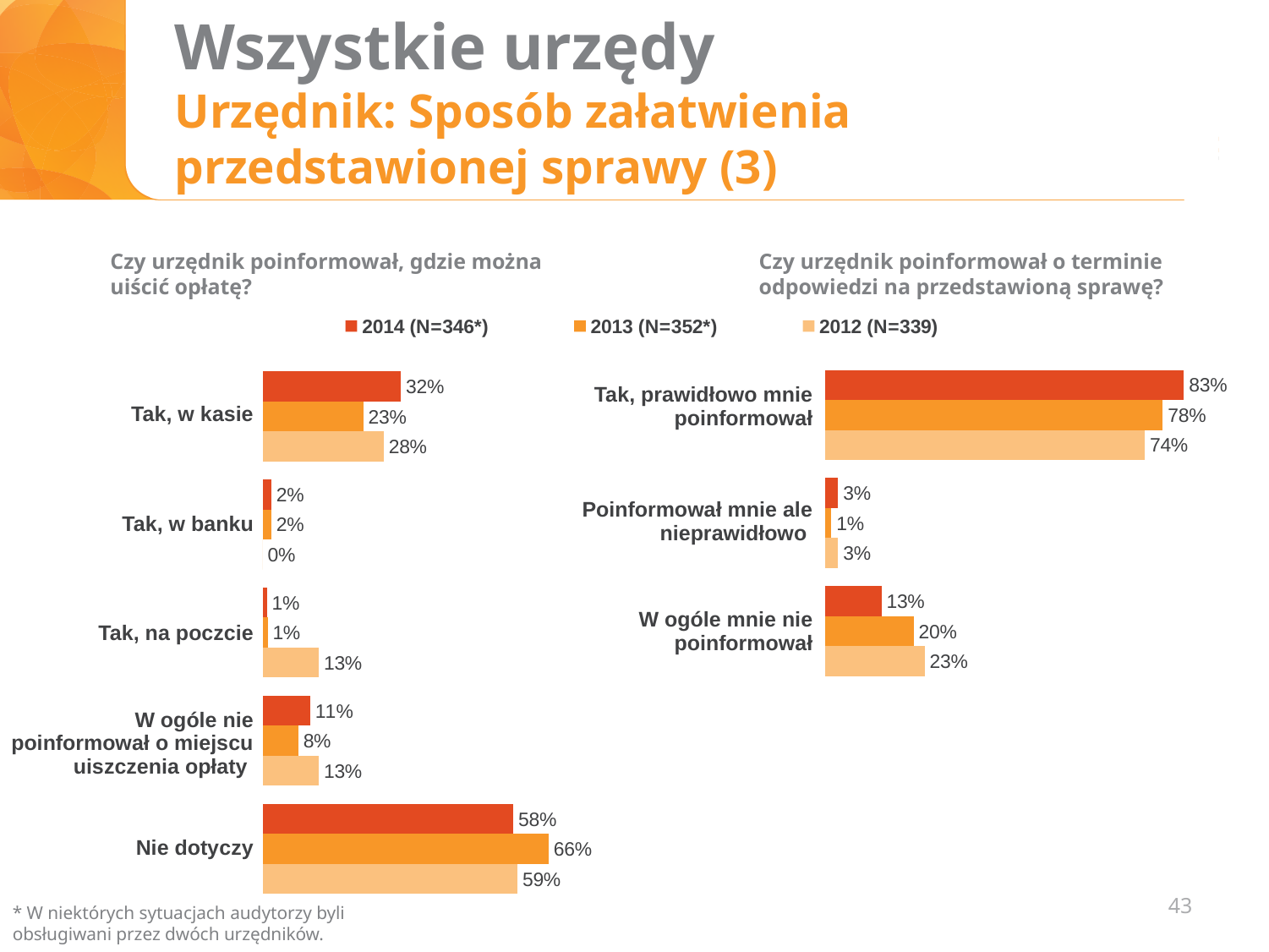
In the right chart, which is larger for "W ogóle mnie nie poinformował": the 2013 value or the 2014 value? 2013 In the right chart ("Czy urzędnik poinformował o terminie odpowiedzi na przedstawioną sprawę?"), what is the value for "Tak, prawidłowo mnie poinformował" in 2012? 74% In the right chart, what is the difference between the 2014 and 2012 values for "Tak, prawidłowo mnie poinformował"? 9 percentage points In the left chart, what is the difference between the 2013 and 2014 values for "Nie dotyczy"? 8 percentage points How many series does the legend list? 3 In the left chart, which is larger for "Tak, na poczcie": the 2012 value or the 2014 value? 2012 In the right chart, which category has the highest value in 2014? Tak, prawidłowo mnie poinformował What type of chart is used on this slide? Bar chart In the left chart, what is the value for "Nie dotyczy" in 2013? 66% How many categories does the left chart show? 5 In the left chart ("Czy urzędnik poinformował, gdzie można uiścić opłatę?"), what is the value for "Tak, w kasie" in 2014? 32% In the left chart, which category has the lowest value in 2012? Tak, w banku